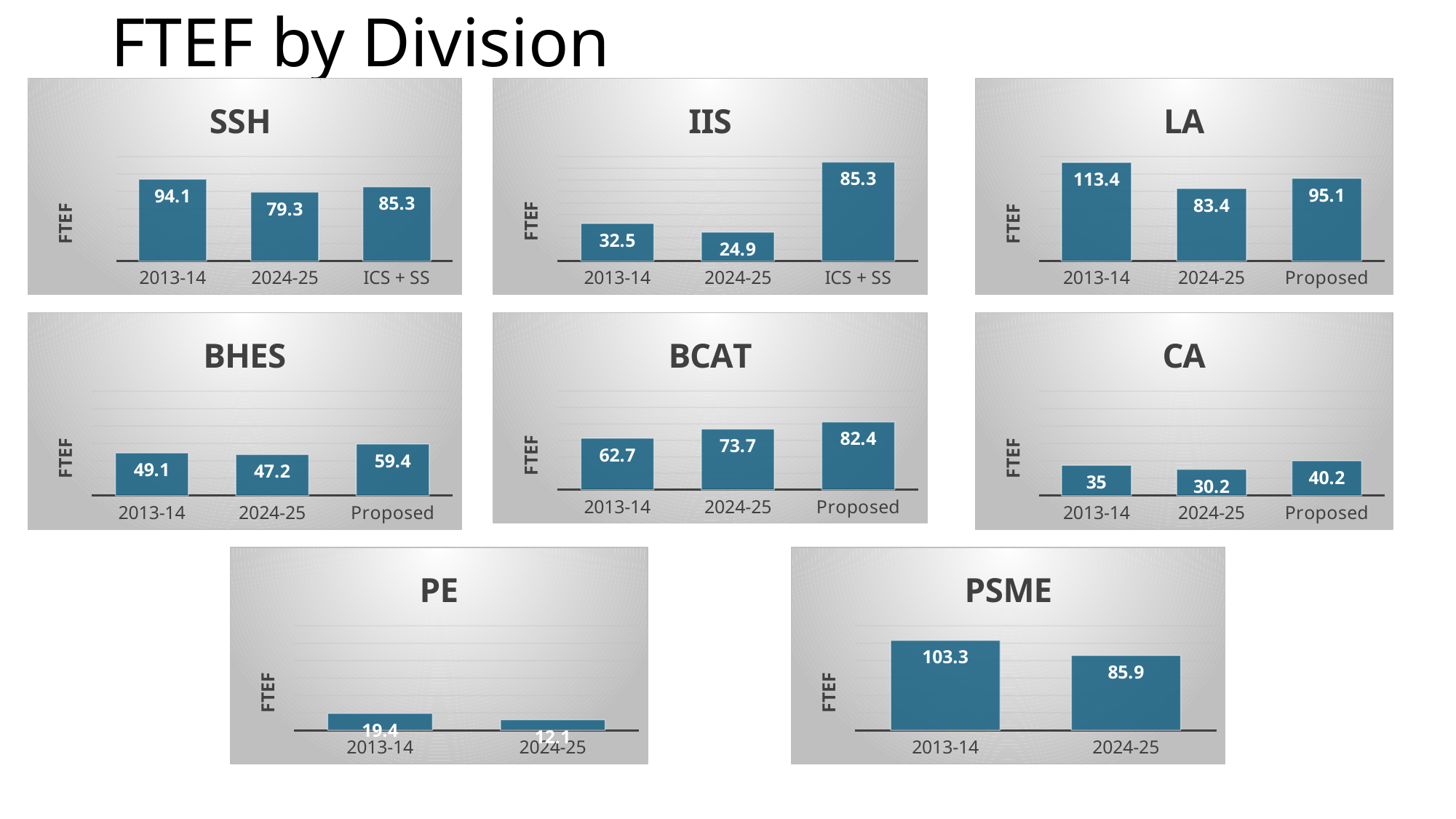
In the IIS chart, what is the FTEF value for ICS + SS? 85.3 What kind of chart is the BCAT chart? bar chart How many charts are shown on the slide? 8 In the SSH chart, what is the FTEF value for 2013-14? 94.1 In the CA chart, which is larger, the value for 2013-14 or the value for 2024-25? 2013-14 In the BCAT chart, do the values rise or fall from 2013-14 to Proposed? rise In the BCAT chart, what is the difference between the Proposed value and the 2013-14 value? 19.7 In the PE chart, how many bars are plotted? 2 In the PSME chart, what is the difference between the 2013-14 value and the 2024-25 value? 17.4 In the LA chart, which category has the highest FTEF value? 2013-14 In the PSME chart, what is the FTEF value for 2024-25? 85.9 In the BHES chart, which category has the lowest FTEF value? 2024-25